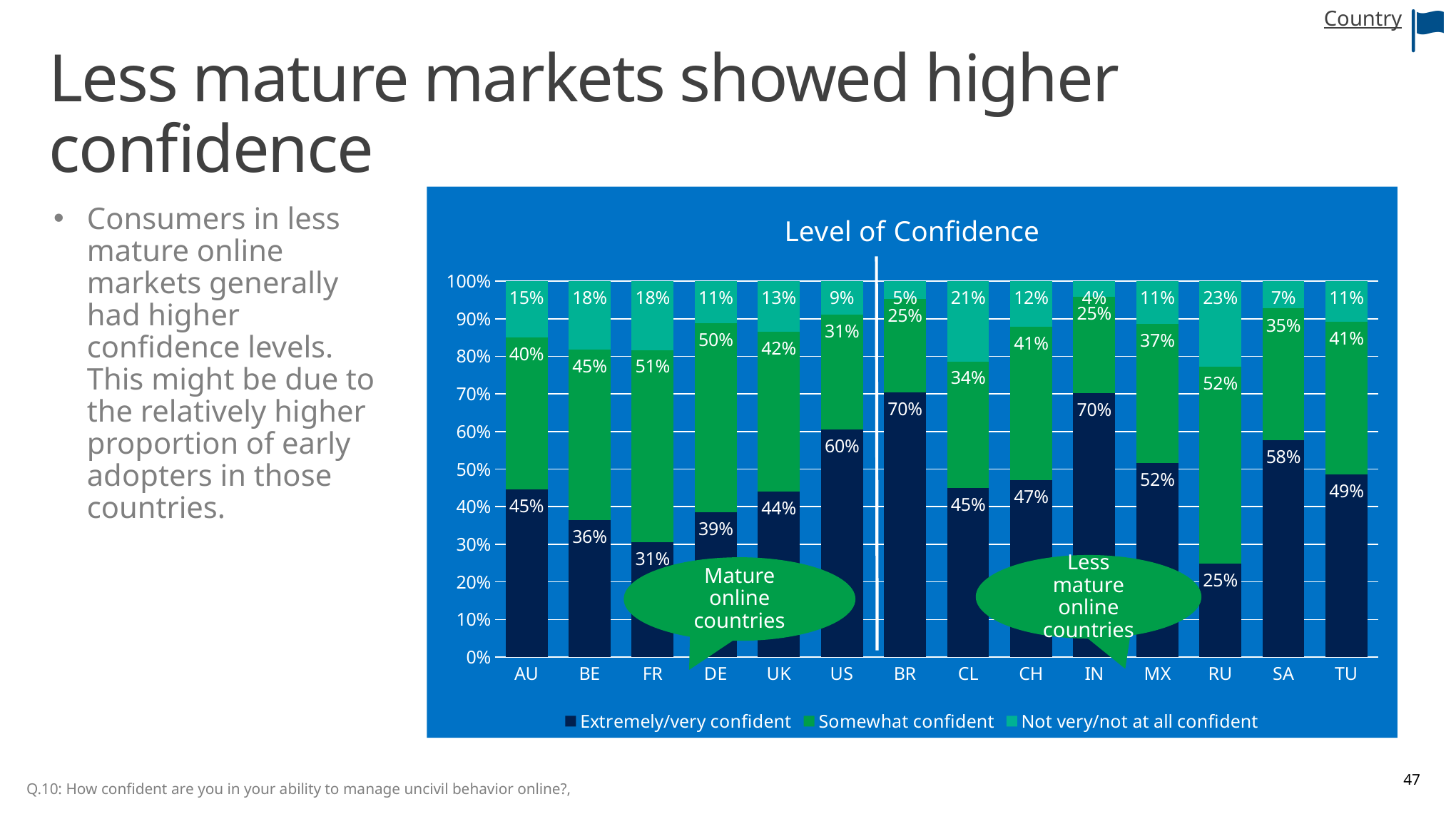
Which country has the lowest Extremely/very confident value? RU What is the Not very/not at all confident value for CL? 21% Which country has the highest Not very/not at all confident value? RU How many series does the legend of the Level of Confidence chart list? 3 What is the Somewhat confident value for FR? 51% What is the Extremely/very confident value for US? 60% How many countries are shown on the x axis of the Level of Confidence chart? 14 What type of chart is shown on the slide? Stacked bar chart What is the title of the chart? Level of Confidence Which has a larger Extremely/very confident value, MX or CH? MX Which country has the lowest Not very/not at all confident value? IN What is the difference between the Extremely/very confident values for SA and BE? 22%